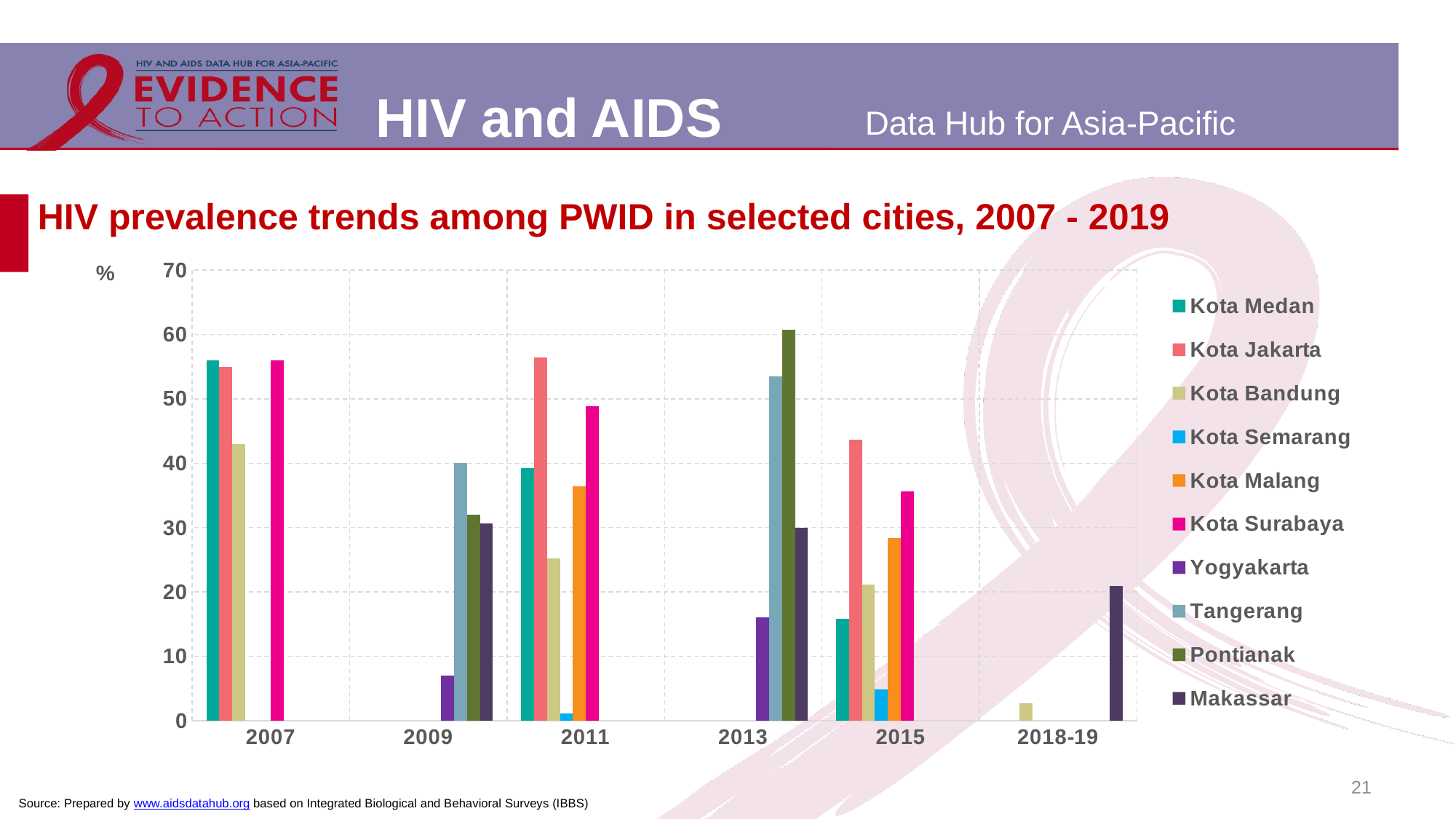
Does the value for Kota Medan rise or fall from 2007 to 2015? Fall What kind of chart is shown on the slide? Bar chart Is the value for Makassar in 2018-19 greater or less than 30? less Which city has the lowest HIV prevalence in 2011? Kota Semarang In 2015, which is larger: the value for Kota Jakarta or the value for Kota Surabaya? Kota Jakarta Is the value for Kota Bandung in 2018-19 greater or less than 10? less Which city has the highest HIV prevalence in 2013? Pontianak How many year categories are shown on the x axis? 6 What is the title of the chart? HIV prevalence trends among PWID in selected cities, 2007 - 2019 How many series does the legend list? 10 Is the value for Tangerang in 2009 greater or less than 30? greater